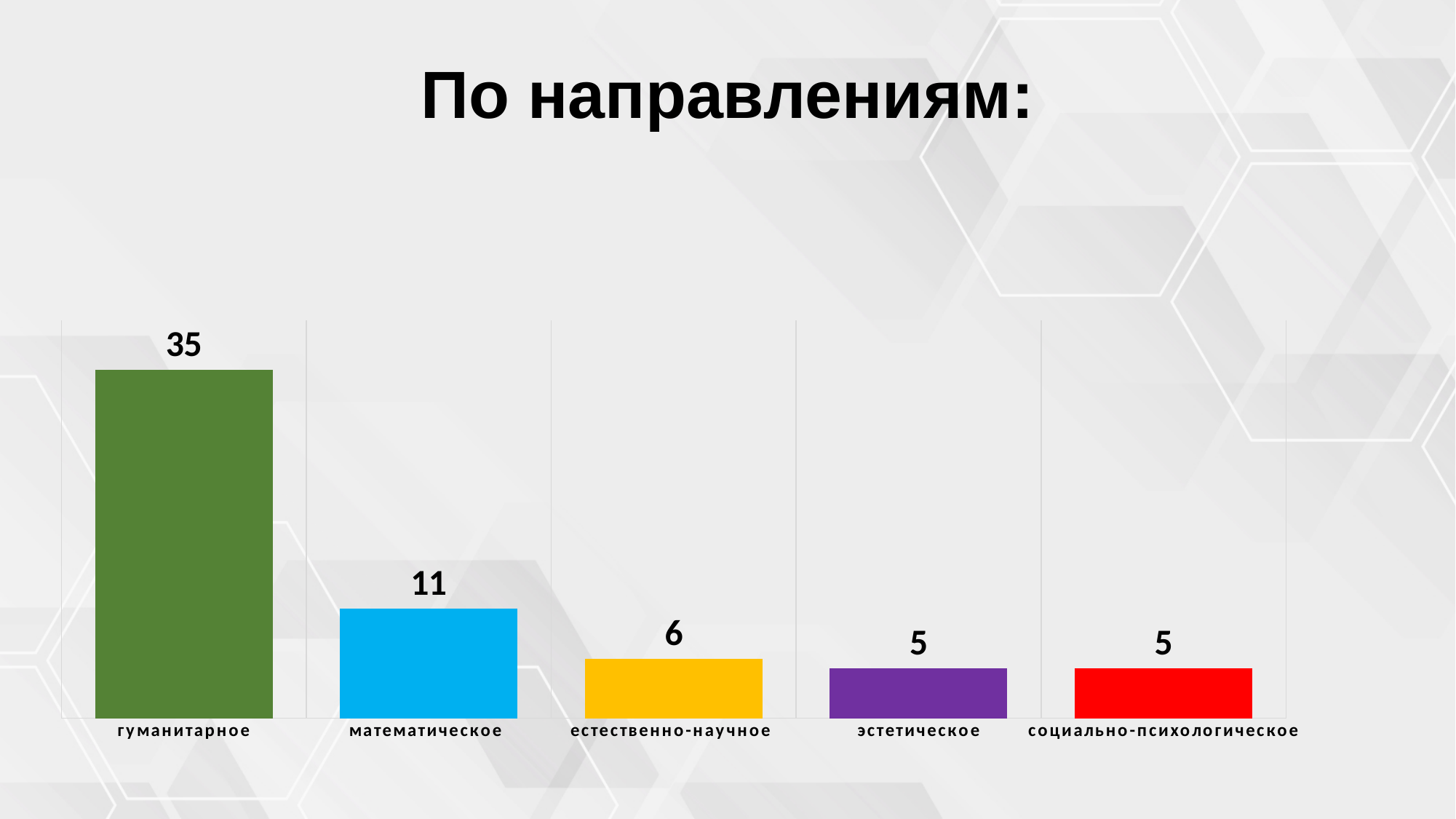
What is the difference between the values for гуманитарное and математическое? 24 What is the title of the slide? По направлениям: Which category has the highest value? гуманитарное What is the difference between the values for математическое and естественно-научное? 5 What kind of chart is shown on the slide? bar chart What is the value for естественно-научное? 6 What is the value for эстетическое? 5 Do the values rise or fall from left to right across the categories? fall Which is larger, the value for математическое or the value for естественно-научное? математическое What is the value for математическое? 11 What is the value for гуманитарное? 35 How many categories are shown in the chart? 5